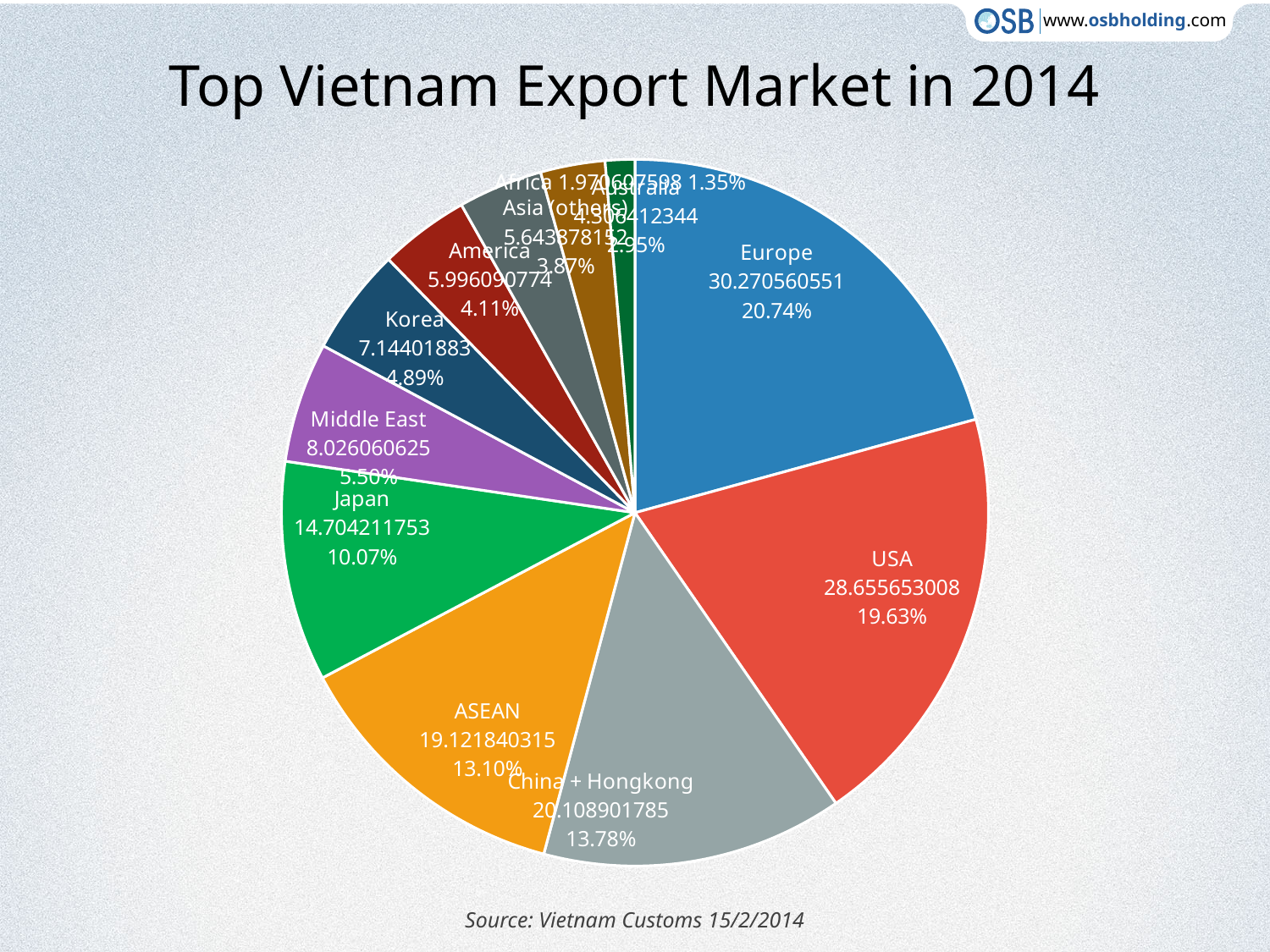
What is the difference in percentage points between the Europe share (20.74%) and the USA share (19.63%)? 1.11 What percentage is shown for China + Hongkong? 13.78% Which export market has the largest slice of the pie? Europe What kind of chart is shown on the slide? pie chart How many slices does the pie chart have? 11 What percentage is shown for Japan? 10.07% What value is printed for the USA slice? 28.655653008 Which slice is larger, ASEAN or China + Hongkong? China + Hongkong What percentage is shown for Korea? 4.89% What is the title of the chart? Top Vietnam Export Market in 2014 What share of the pie does Europe account for? 20.74% What value is printed for the ASEAN slice? 19.121840315